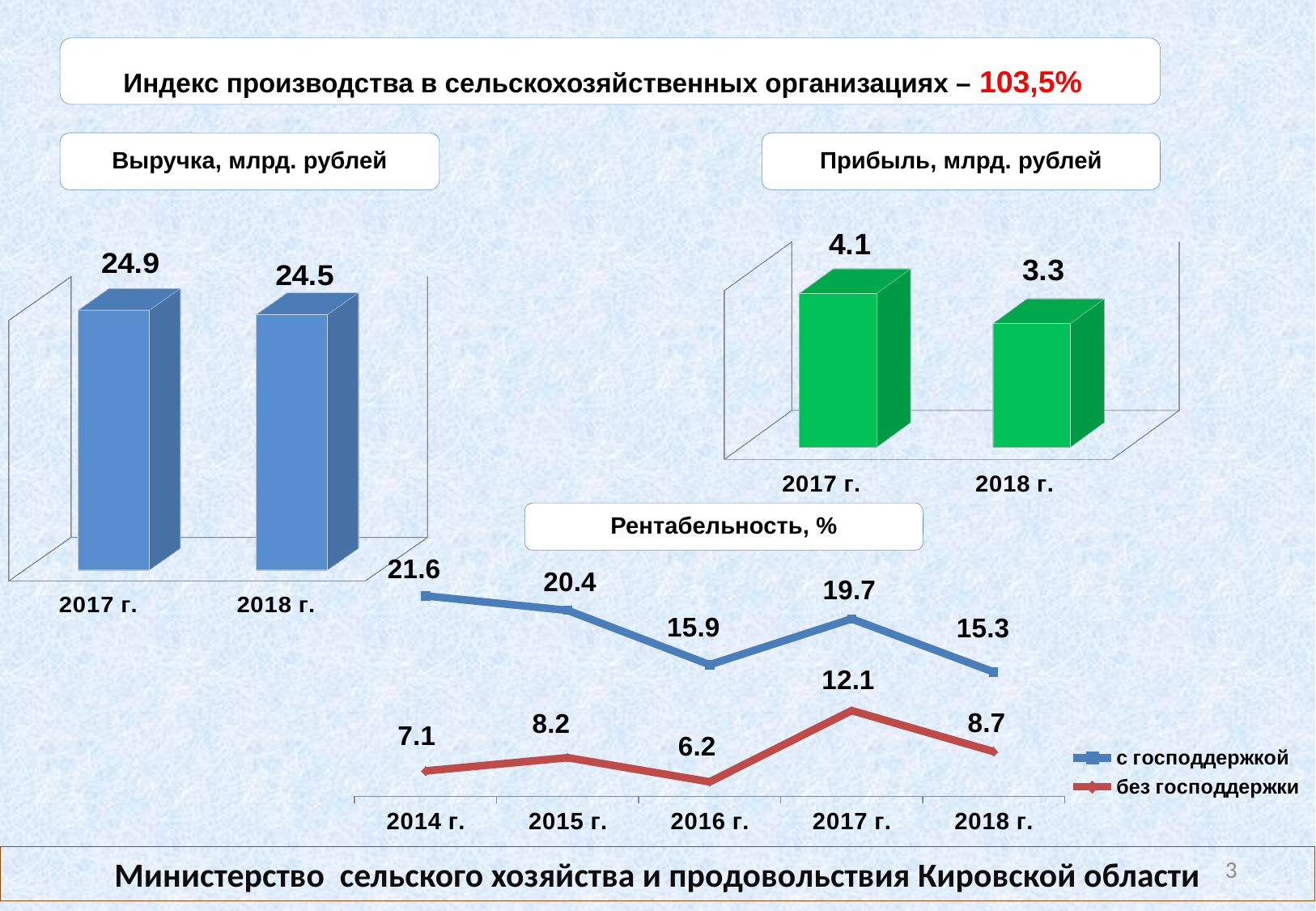
In the 'Выручка, млрд. рублей' chart, what is the value for 2018 г.? 24.5 In the 'Выручка, млрд. рублей' chart, what is the difference between the 2017 г. and 2018 г. values? 0.4 How many years are shown on the x axis of the 'Рентабельность, %' chart? 5 In the 'Рентабельность, %' chart, what is the value for 'с господдержкой' in 2017 г.? 19.7 In the 'Прибыль, млрд. рублей' chart, what is the value for 2017 г.? 4.1 In the 'Рентабельность, %' chart, what is the difference between 'с господдержкой' and 'без господдержки' in 2014 г.? 14.5 In the 'Прибыль, млрд. рублей' chart, what is the difference between the 2017 г. and 2018 г. values? 0.8 In the 'Рентабельность, %' chart, in which year is the 'без господдержки' series highest? 2017 г. What kind of chart is the 'Рентабельность, %' chart? Line chart In the 'Рентабельность, %' chart, what is the value for 'без господдержки' in 2016 г.? 6.2 How many series does the legend of the 'Рентабельность, %' chart list? 2 In the 'Прибыль, млрд. рублей' chart, which year has the lower value? 2018 г.